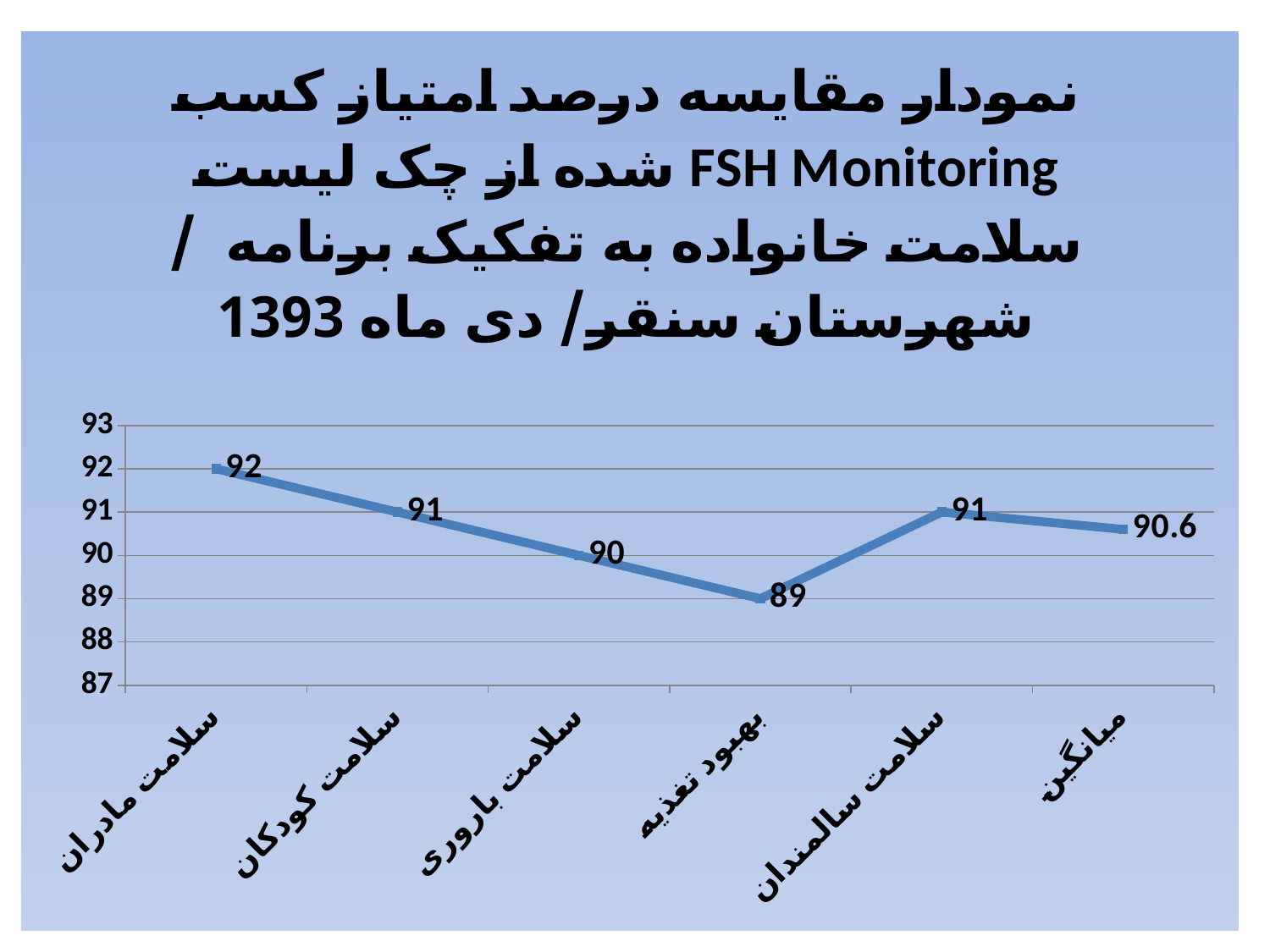
What is the value for سلامت باروری? 90 Do the values rise or fall from سلامت مادران to بهبود تغذیه? fall Which is larger, the value for سلامت سالمندان or the value for میانگین? سلامت سالمندان What is the value for سلامت مادران? 92 What is the value for میانگین? 90.6 Which category has the lowest value? بهبود تغذیه What is the difference between the values for سلامت مادران and بهبود تغذیه? 3 What is the difference between the values for سلامت کودکان and سلامت باروری? 1 Which category has the highest value? سلامت مادران What is the value for بهبود تغذیه? 89 What kind of chart is shown on the slide? line chart How many categories are plotted on the x axis? 6